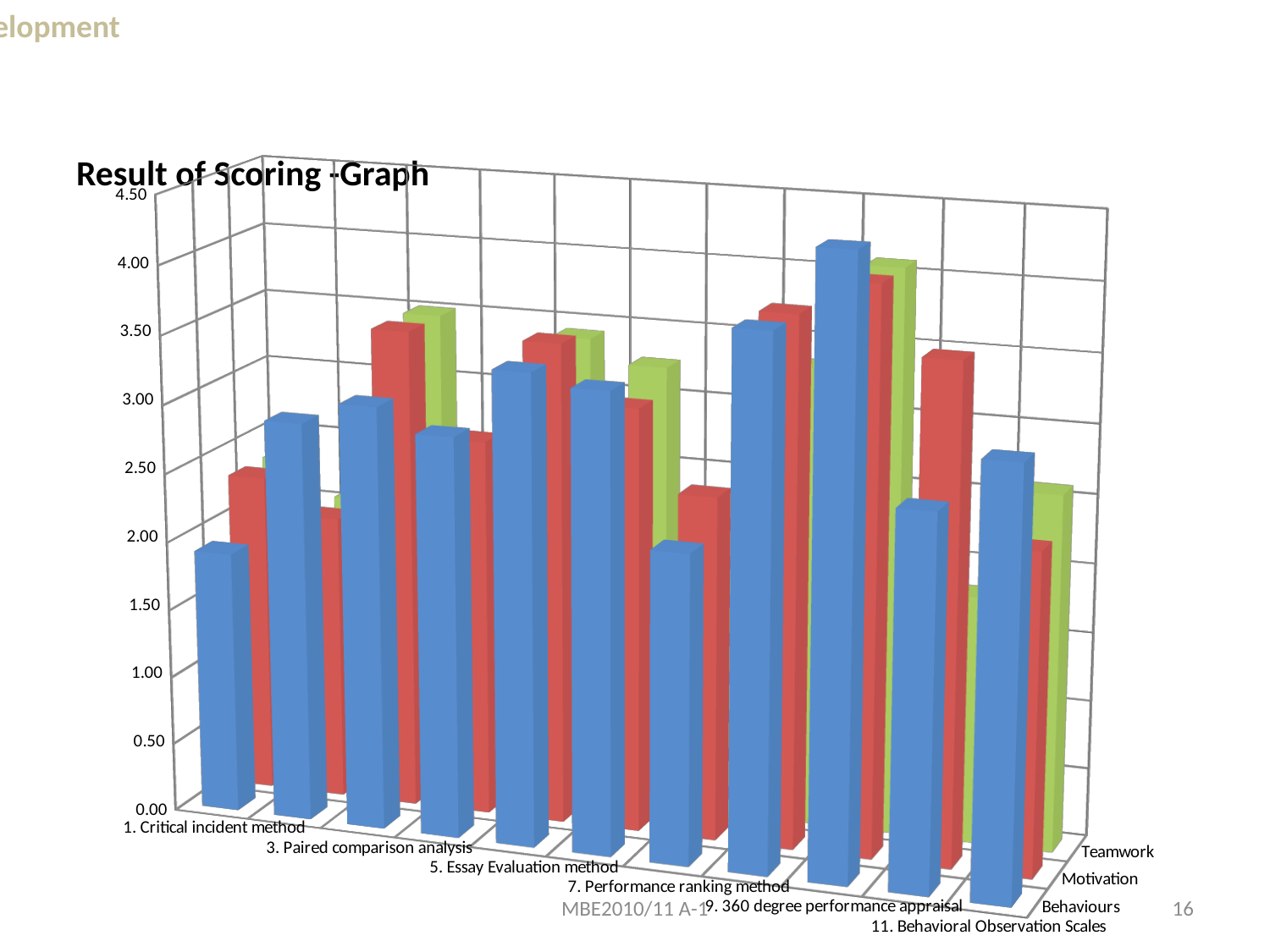
How many series does the chart plot? 3 What kind of chart is shown on the slide? bar chart What is the title of the chart? Result of Scoring -Graph Which has the larger Behaviours value: 9. 360 degree performance appraisal or 1. Critical incident method? 9. 360 degree performance appraisal What is the maximum value shown on the vertical axis? 4.50 Which colour represents the Behaviours series? blue Which category has the highest Behaviours value? 9. 360 degree performance appraisal Is the Behaviours value for 9. 360 degree performance appraisal greater or less than 3.00? greater Is the Behaviours value for 1. Critical incident method greater or less than 3.00? less How many appraisal methods (categories) are plotted along the x axis? 11 Which has the larger Behaviours value: 9. 360 degree performance appraisal or 11. Behavioral Observation Scales? 9. 360 degree performance appraisal